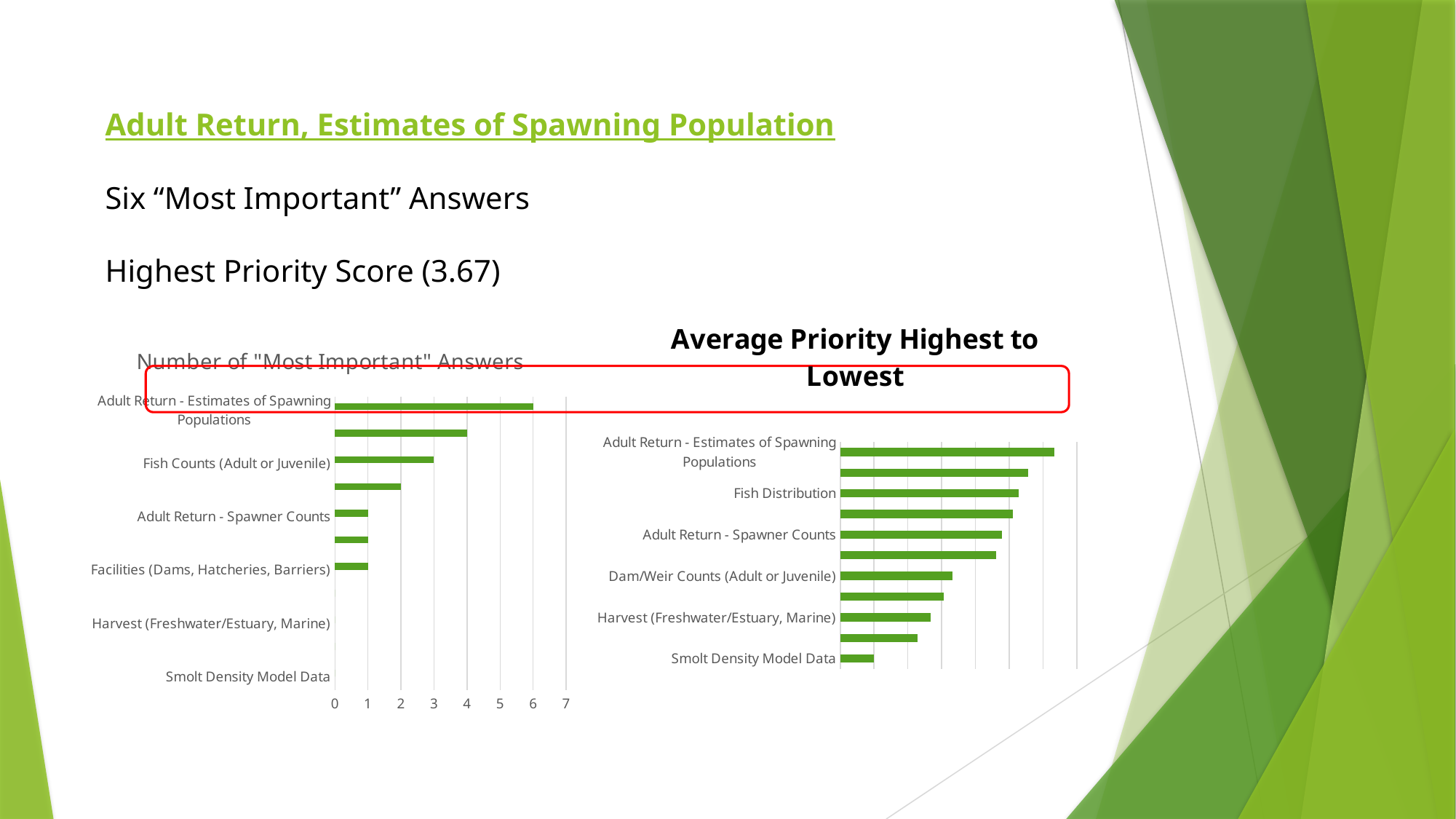
In the "Average Priority Highest to Lowest" chart, which is larger: Fish Distribution or Harvest (Freshwater/Estuary, Marine)? Fish Distribution In the "Average Priority Highest to Lowest" chart, which category has the lowest value? Smolt Density Model Data In the "Number of "Most Important" Answers" chart, which is larger: Fish Counts (Adult or Juvenile) or Adult Return - Spawner Counts? Fish Counts (Adult or Juvenile) In the "Number of "Most Important" Answers" chart, which category has the highest value? Adult Return - Estimates of Spawning Populations In the "Number of "Most Important" Answers" chart, what is the value for Adult Return - Spawner Counts? 1 What kind of chart is the "Number of "Most Important" Answers" chart on the left? bar chart In the "Average Priority Highest to Lowest" chart, which category has the highest value? Adult Return - Estimates of Spawning Populations In the "Number of "Most Important" Answers" chart, what is the value for Fish Counts (Adult or Juvenile)? 3 In the "Number of "Most Important" Answers" chart, what is the value for Adult Return - Estimates of Spawning Populations? 6 In the "Number of "Most Important" Answers" chart, what is the difference between Adult Return - Estimates of Spawning Populations and Fish Counts (Adult or Juvenile)? 3 In the "Number of "Most Important" Answers" chart, what is the value for Facilities (Dams, Hatcheries, Barriers)? 1 In the "Number of "Most Important" Answers" chart, is the value for Adult Return - Estimates of Spawning Populations greater or less than 5? greater